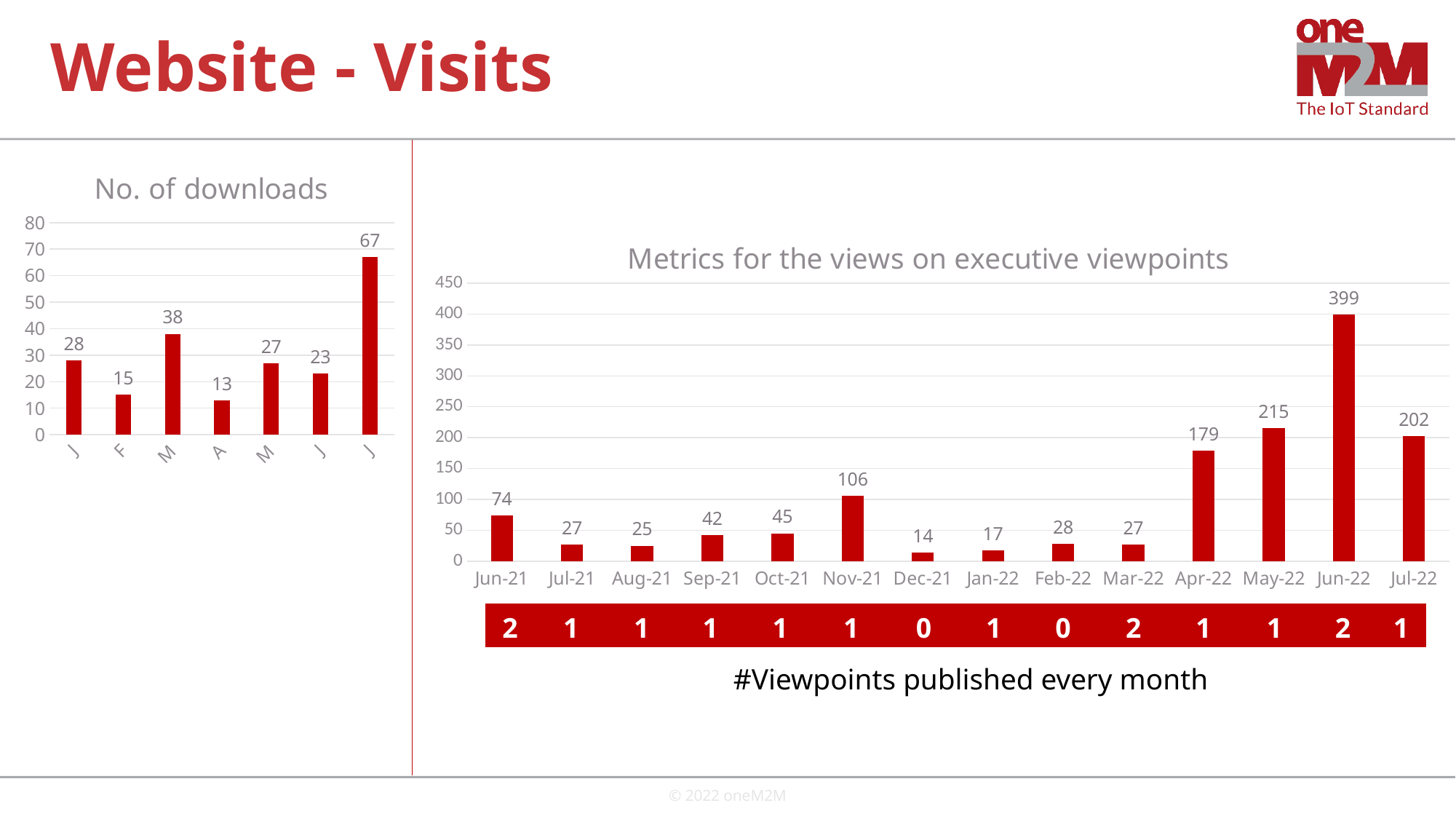
In the 'Metrics for the views on executive viewpoints' chart, how many months are shown on the x axis? 14 What kind of chart is the 'No. of downloads' chart? Bar chart In the 'No. of downloads' chart, what is the value of the tallest bar? 67 In the 'Metrics for the views on executive viewpoints' chart, which is larger, the value for Sep-21 or the value for Oct-21? Oct-21 In the 'Metrics for the views on executive viewpoints' chart, is the value for Jul-22 greater or less than 200? greater In the 'Metrics for the views on executive viewpoints' chart, which month has the lowest value? Dec-21 In the 'Metrics for the views on executive viewpoints' chart, what is the value for Nov-21? 106 In the 'Metrics for the views on executive viewpoints' chart, what is the value for Apr-22? 179 In the 'No. of downloads' chart, what is the value of the lowest bar? 13 In the 'Metrics for the views on executive viewpoints' chart, what is the difference between the values for Jun-22 and May-22? 184 In the 'Metrics for the views on executive viewpoints' chart, which month has the highest value? Jun-22 In the 'No. of downloads' chart, how many bars are plotted? 7